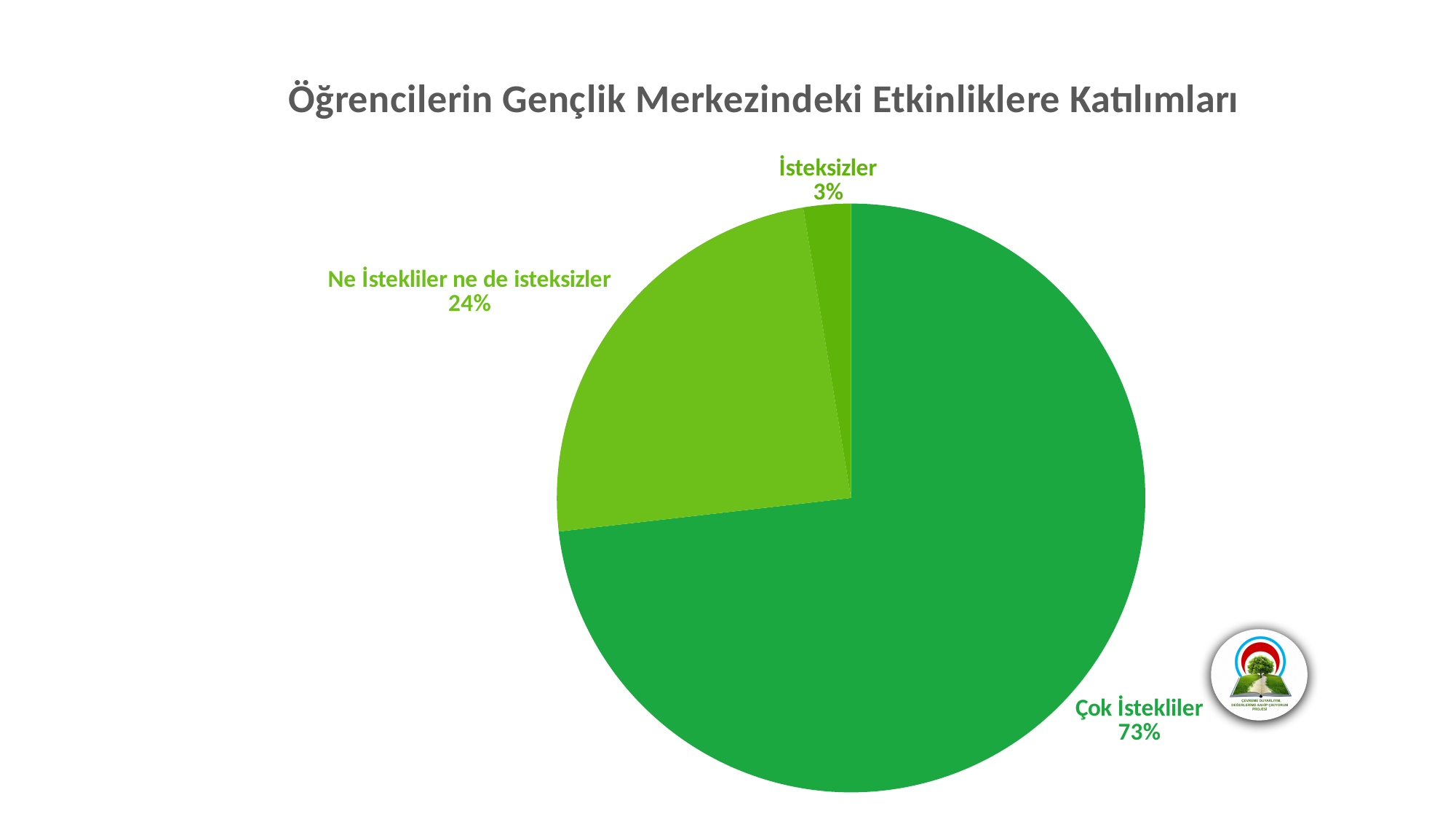
What is the title of the chart? Öğrencilerin Gençlik Merkezindeki Etkinliklere Katılımları What is the difference in percentage points between "Ne İstekliler ne de isteksizler" and "İsteksizler"? 21 Which is larger, the share for "Ne İstekliler ne de isteksizler" or the share for "İsteksizler"? Ne İstekliler ne de isteksizler What is the combined share of "Ne İstekliler ne de isteksizler" and "İsteksizler"? 27% How many categories are shown in the pie chart? 3 Which category has the largest slice of the pie? Çok İstekliler Which category has the smallest slice of the pie? İsteksizler What kind of chart is shown on the slide? Pie chart What share of the pie does "Ne İstekliler ne de isteksizler" represent? 24% What is the difference in percentage points between "Çok İstekliler" and "Ne İstekliler ne de isteksizler"? 49 What share of the pie does "İsteksizler" represent? 3% What share of the pie does "Çok İstekliler" represent? 73%